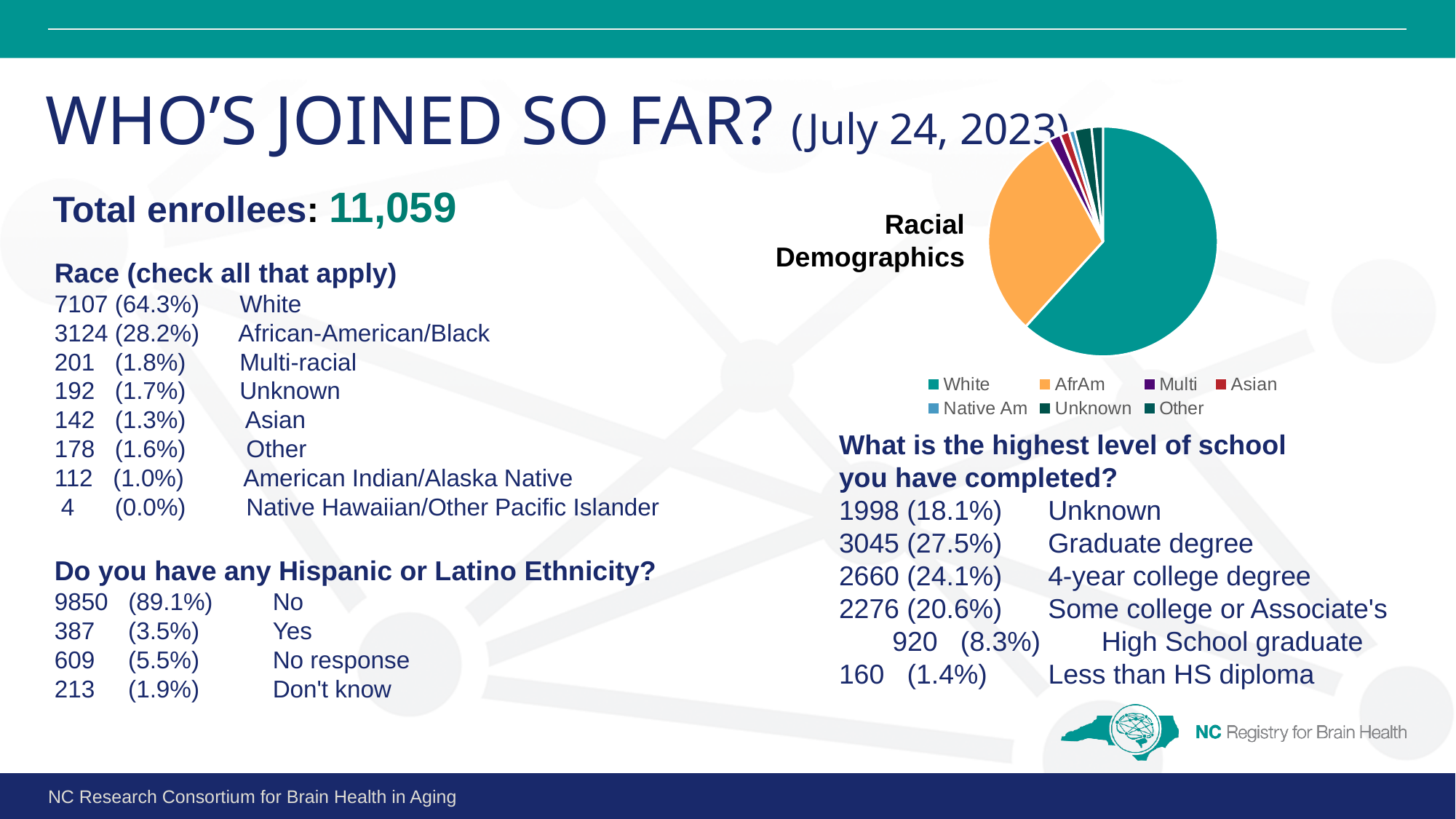
In the Racial Demographics pie chart, is the AfrAm slice larger or smaller than the Multi slice? larger What kind of chart is the Racial Demographics chart? pie chart Which of the two slices is larger in the Racial Demographics pie chart, White or AfrAm? White What colour is the White slice in the Racial Demographics pie chart? teal What is the title of the pie chart on the slide? Racial Demographics Is the White slice of the Racial Demographics pie chart greater or less than half of the pie? greater How many categories does the legend of the Racial Demographics pie chart list? 7 Which legend entry in the Racial Demographics pie chart is shown in orange? AfrAm Which category has the largest slice in the Racial Demographics pie chart? White